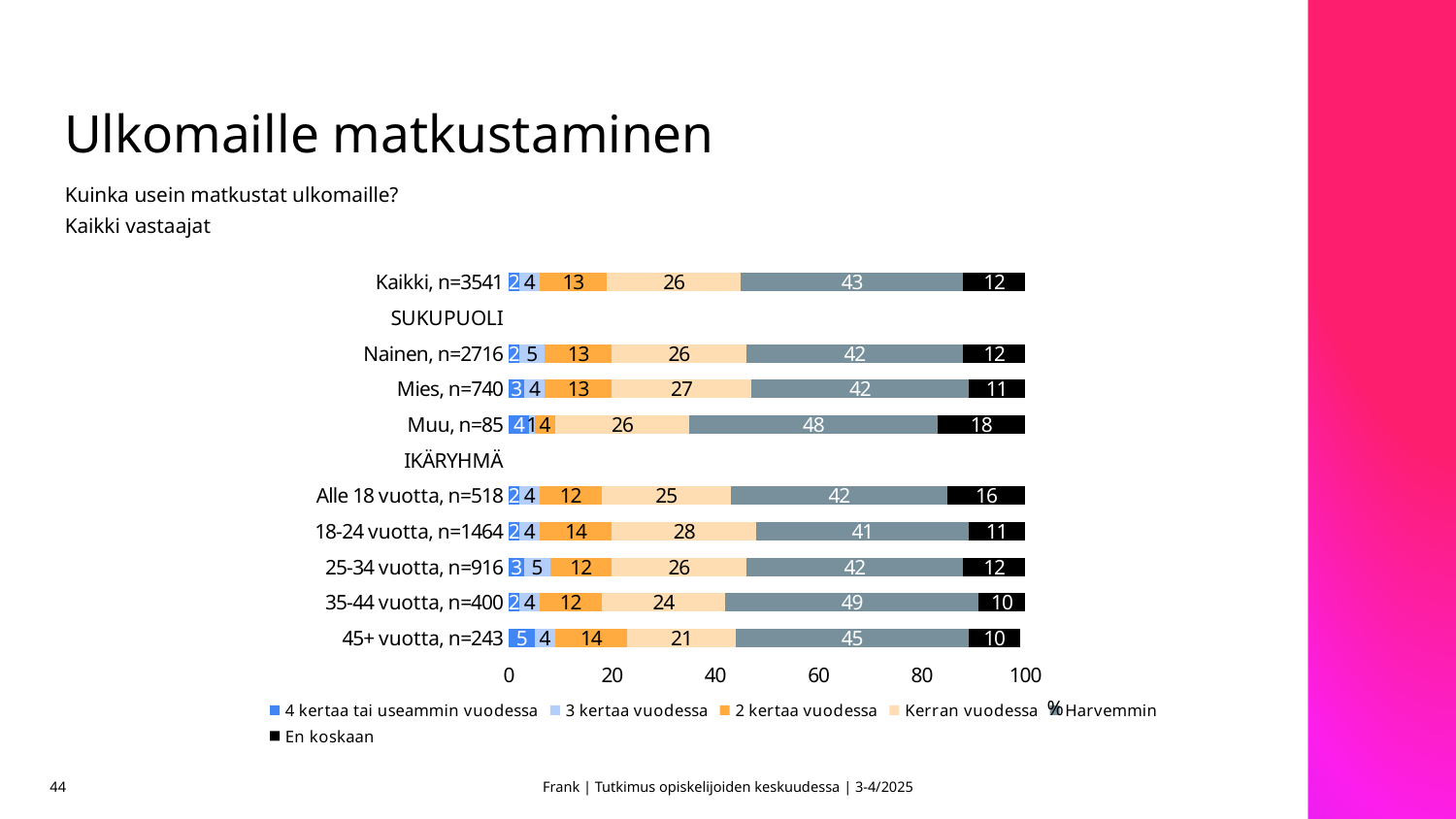
What is the difference between the "En koskaan" values for Alle 18 vuotta, n=518 and 35-44 vuotta, n=400? 6 What is the value of "4 kertaa tai useammin vuodessa" for 45+ vuotta, n=243? 5 Which is larger: the "2 kertaa vuodessa" value for 18-24 vuotta, n=1464 or for 35-44 vuotta, n=400? 18-24 vuotta, n=1464 How many respondent groups (bars) are plotted in the chart? 9 What kind of chart is shown on the slide? Stacked bar chart How many series does the legend list? 6 What is the value of "Kerran vuodessa" for 18-24 vuotta, n=1464? 28 Which group has the lowest value for "Kerran vuodessa"? 45+ vuotta, n=243 Which group has the highest value for "Harvemmin"? 35-44 vuotta, n=400 What is the total of the stacked bar for Mies, n=740? 100 What is the value of "Harvemmin" for Kaikki, n=3541? 43 What is the value of "En koskaan" for Muu, n=85? 18